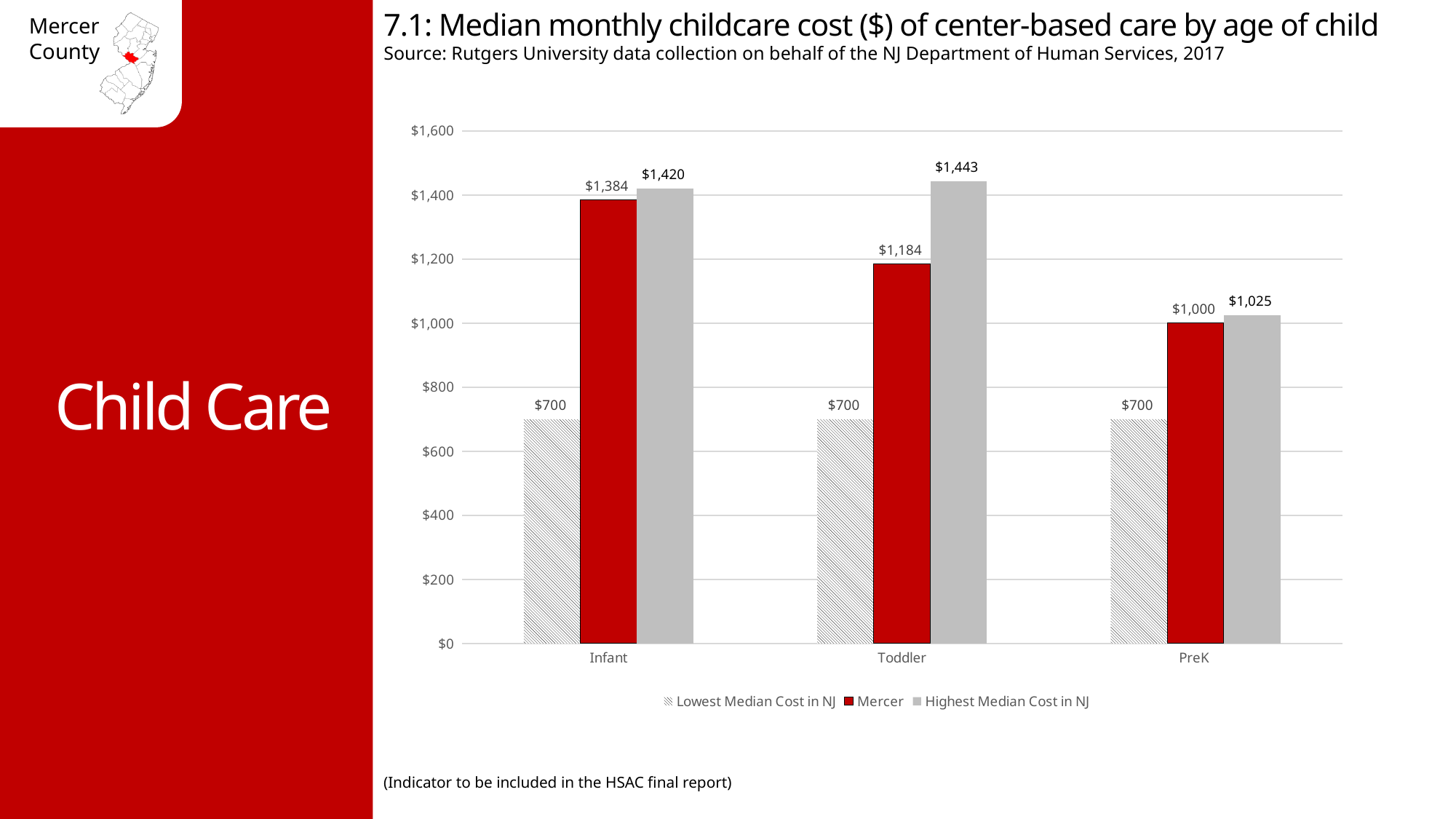
What is the Highest Median Cost in NJ for Toddler care? $1,443 What is the Mercer median monthly childcare cost for Infant care? $1,384 Which age group has the lowest Highest Median Cost in NJ? PreK What kind of chart is shown on the slide? Bar chart What is the Mercer value for PreK? $1,000 Which age group has the highest Mercer median monthly cost? Infant How many age groups are shown on the x axis? 3 How many series does the legend list? 3 What is the difference between the Mercer value for Toddler and the Mercer value for PreK? $184 What is the Lowest Median Cost in NJ for PreK care? $700 Which is larger for Toddler care: the Mercer value or the Highest Median Cost in NJ? Highest Median Cost in NJ What is the difference between the Highest Median Cost in NJ and the Mercer value for Infant care? $36